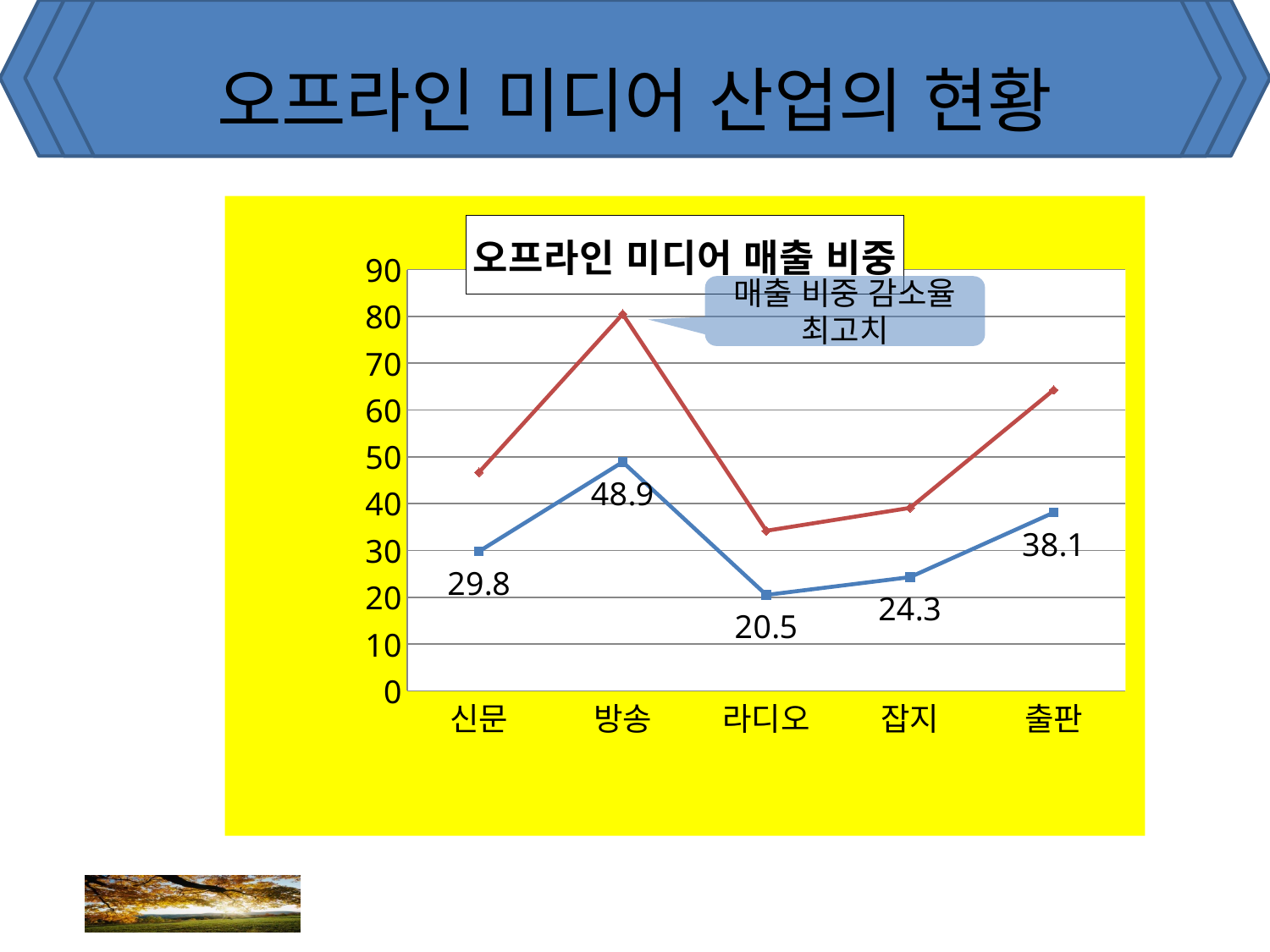
How many categories are shown on the x axis of the chart? 5 What is the value of the blue line for 출판? 38.1 Which category has the highest value on the blue line? 방송 What is the title of the chart? 오프라인 미디어 매출 비중 Which category has the lowest value on the blue line? 라디오 What is the value of the blue line for 방송? 48.9 Which category has the highest value on the red line? 방송 What is the difference between the blue line values for 방송 and 신문? 19.1 What kind of chart is shown on the slide? line chart On the blue line, which is larger: the value for 신문 or the value for 잡지? 신문 Is the value of the red line for 방송 greater or less than 70? greater What is the value of the blue line for 라디오? 20.5